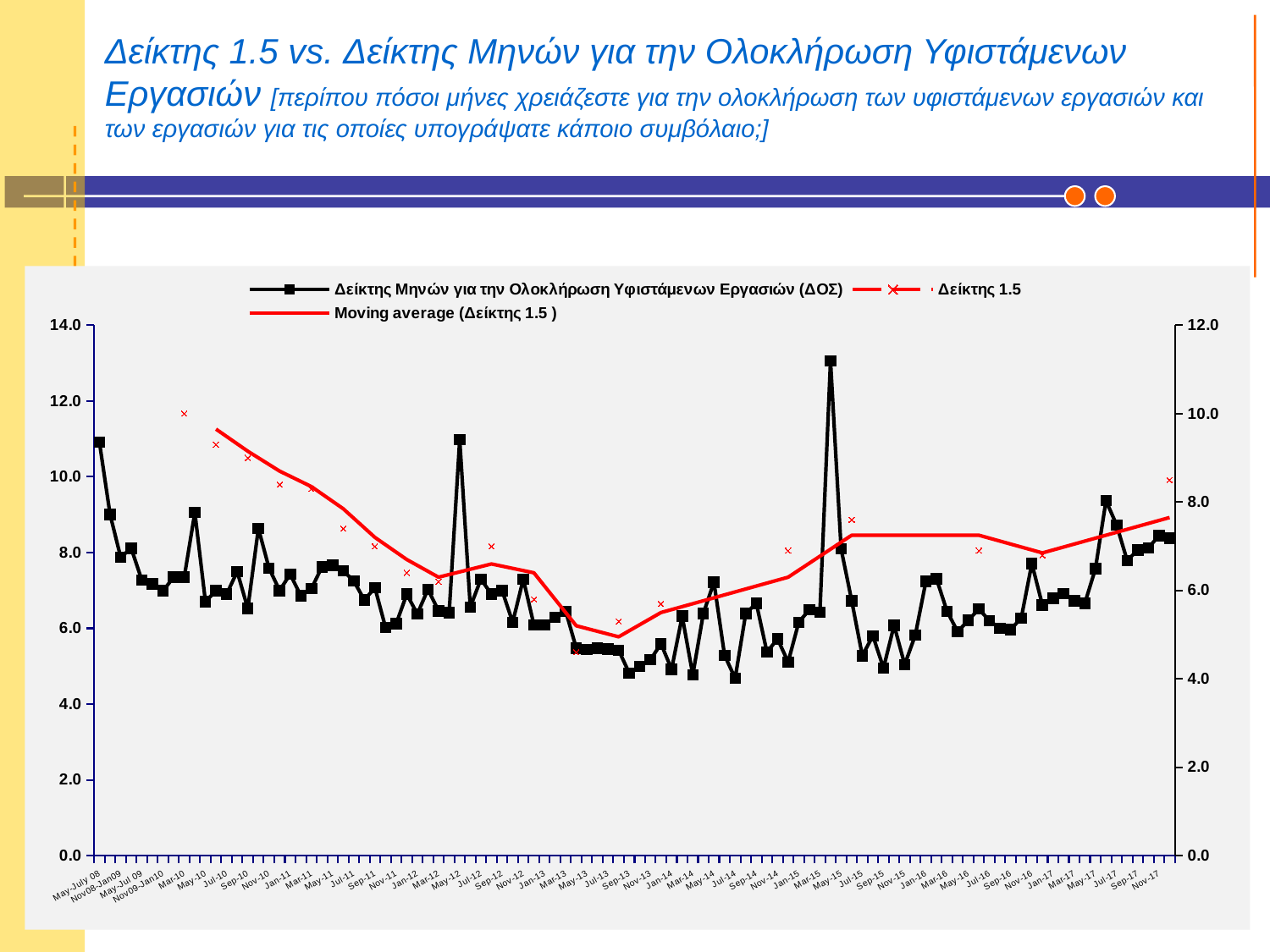
Does the Moving average (Δείκτης 1.5) line rise or fall between Jul-10 and Sep-13? fall Is the highest peak of the black ΔΟΣ series (around 2015) greater or less than 10.0? greater Is the value of the black ΔΟΣ series at the first point (May-July 08) greater or less than 8.0? greater Is the lowest point of the black ΔΟΣ series (around Sep-13) greater or less than 6.0? less What kind of chart is shown on the slide? line chart In which year does the black ΔΟΣ series reach its highest peak? 2015 What is the highest value shown on the left vertical axis? 14.0 How many series does the legend list? 3 What is the highest value shown on the right vertical axis? 12.0 Does the Moving average (Δείκτης 1.5) line rise or fall between Sep-13 and Nov-17? rise